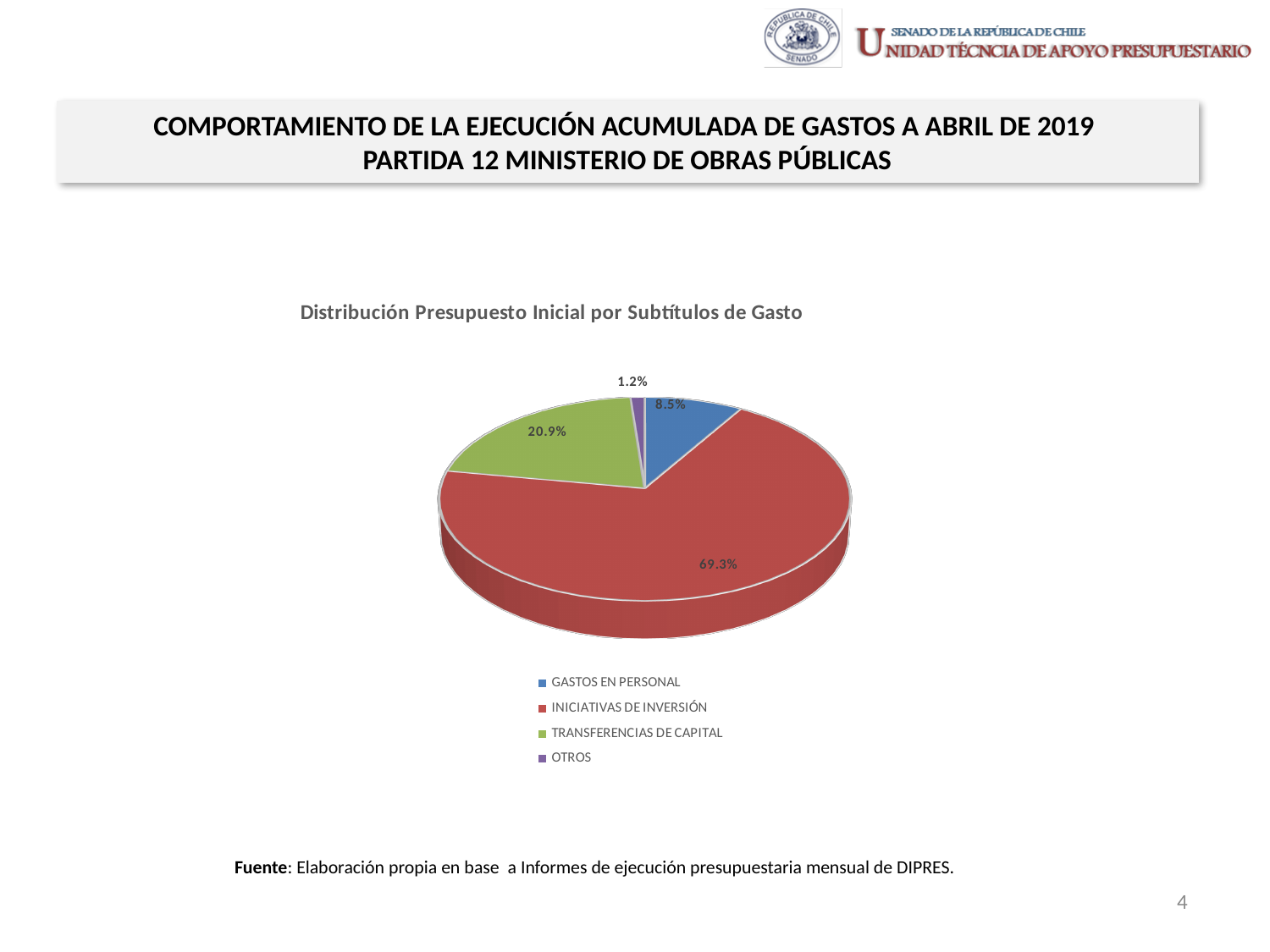
What colour is the slice for INICIATIVAS DE INVERSIÓN? red What share of the pie does GASTOS EN PERSONAL represent? 8.5% What is the title of the chart? Distribución Presupuesto Inicial por Subtítulos de Gasto What kind of chart is shown on the slide? pie chart What share of the pie does OTROS represent? 1.2% What share of the pie does INICIATIVAS DE INVERSIÓN represent? 69.3% Which is larger, the share for GASTOS EN PERSONAL or the share for TRANSFERENCIAS DE CAPITAL? TRANSFERENCIAS DE CAPITAL How many categories does the pie chart show? 4 Which category has the largest slice of the pie? INICIATIVAS DE INVERSIÓN Which category has the smallest slice of the pie? OTROS What is the difference in percentage points between INICIATIVAS DE INVERSIÓN and TRANSFERENCIAS DE CAPITAL? 48.4